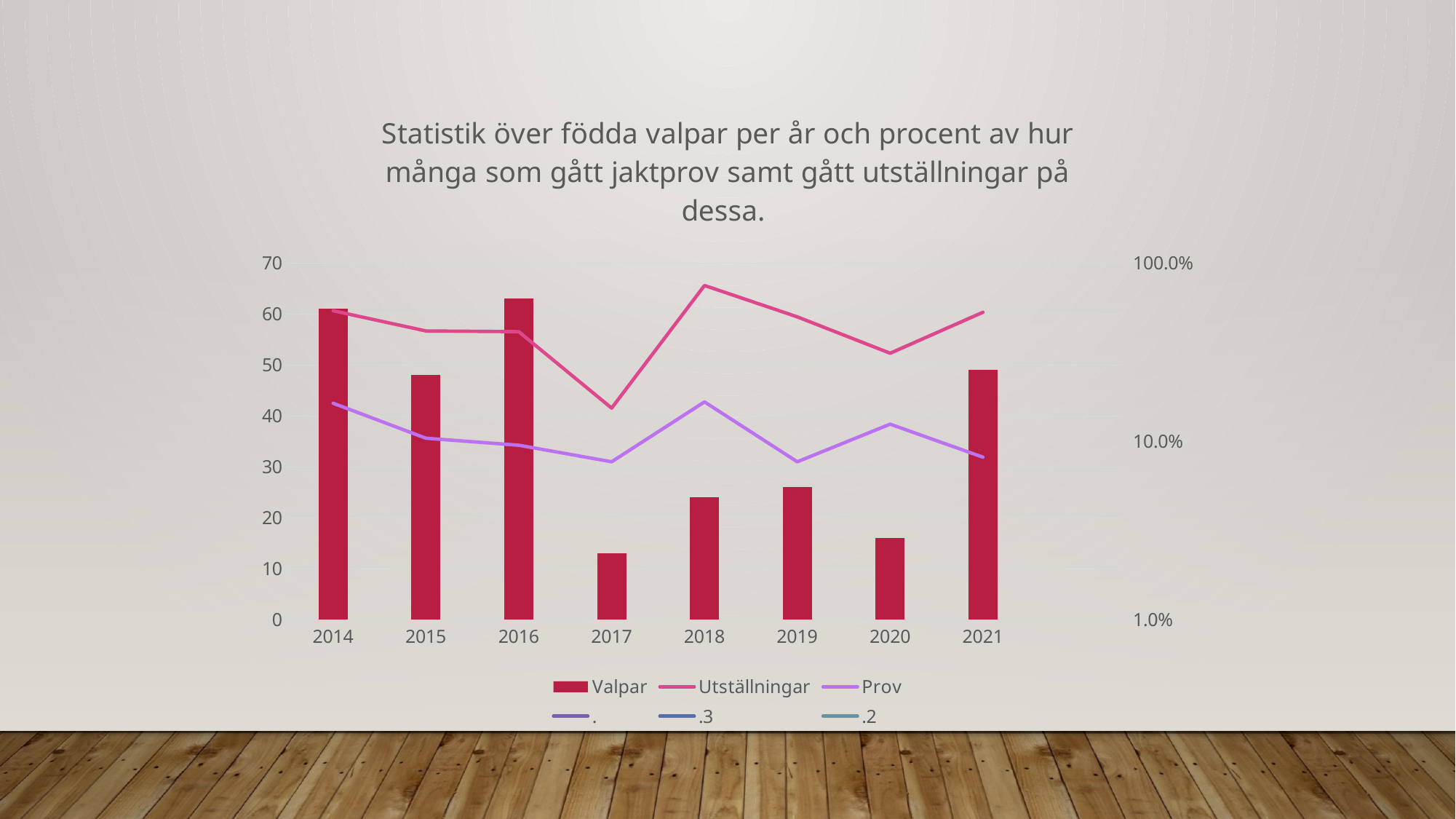
Is the Valpar value for 2016 greater or less than 60? greater Does the Utställningar line rise or fall from 2014 to 2017? It falls What kind of chart is shown on the slide? A combination bar and line chart Is the Valpar value for 2018 greater or less than 20? greater How many entries does the chart's legend list? 6 Is the Prov value for 2017 greater or less than 10.0%? less In 2018, which line is higher, Utställningar or Prov? Utställningar Which is larger, the Valpar bar for 2017 or for 2020? 2020 How many years are shown on the x axis of the chart? 8 Which year has the lowest Valpar bar? 2017